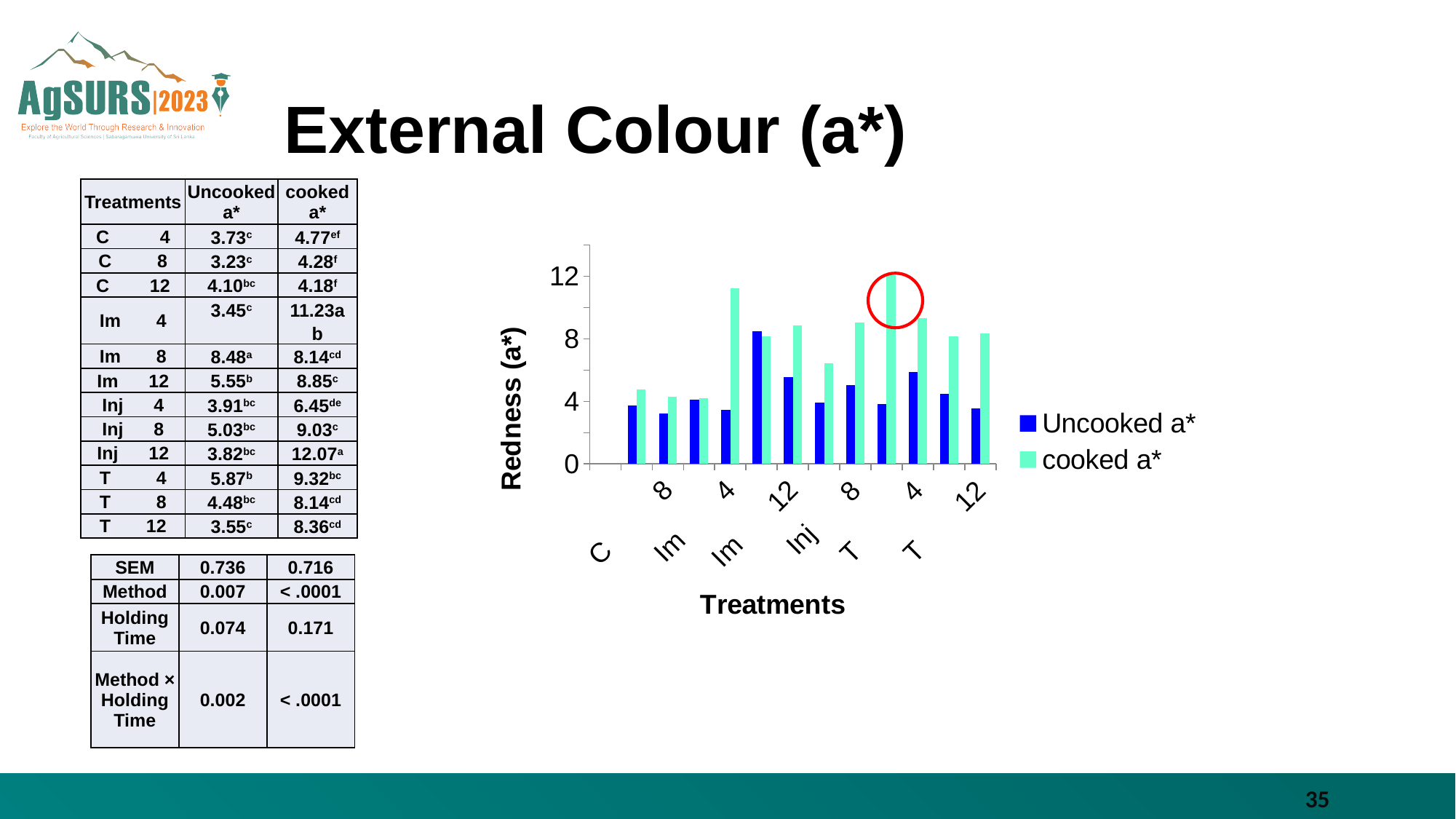
What kind of chart is shown on the slide? bar chart What is the highest tick value shown on the chart's vertical axis? 12 How many treatment groups (pairs of bars) are plotted in the chart? 12 In the rightmost group (T 12), which bar is taller, Uncooked a* or cooked a*? cooked a* How many series does the chart legend list? 2 What are the two series named in the chart legend? Uncooked a* and cooked a* Is the value of the circled cooked a* bar greater or less than 8? greater Which series contains the tallest bar in the chart? cooked a* What is the title of the chart's vertical axis? Redness (a*) In the leftmost group (C), which bar is taller, Uncooked a* or cooked a*? cooked a* Is the value of the tallest Uncooked a* bar greater or less than 8? greater